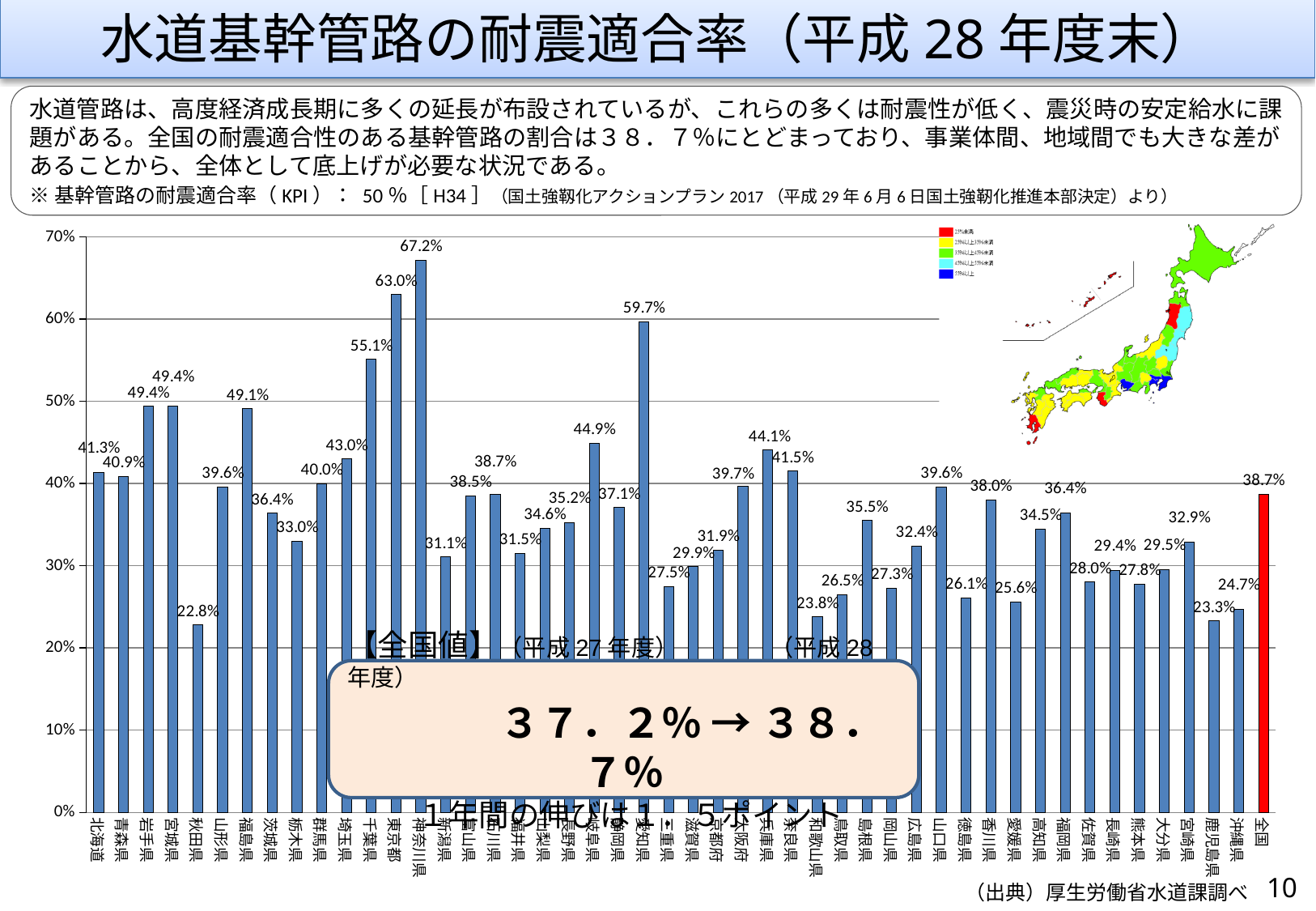
What kind of chart is shown on the slide? bar chart What is the difference between the values for 神奈川県 and 東京都? 4.2 percentage points What is the value shown for 鹿児島県 in the bar chart? 23.3% What is the value shown for 全国 in the bar chart? 38.7% Is the value for 沖縄県 greater or less than 30%? less Which category has the highest value in the bar chart? 神奈川県 Which has the larger value, 千葉県 or 埼玉県? 千葉県 How many bars are plotted in the bar chart? 48 What is the value shown for 神奈川県 in the bar chart? 67.2% What is the value shown for 福島県 in the bar chart? 49.1% Which category has the lowest value in the bar chart? 秋田県 What is the difference between the values for 全国 and 沖縄県? 14.0 percentage points